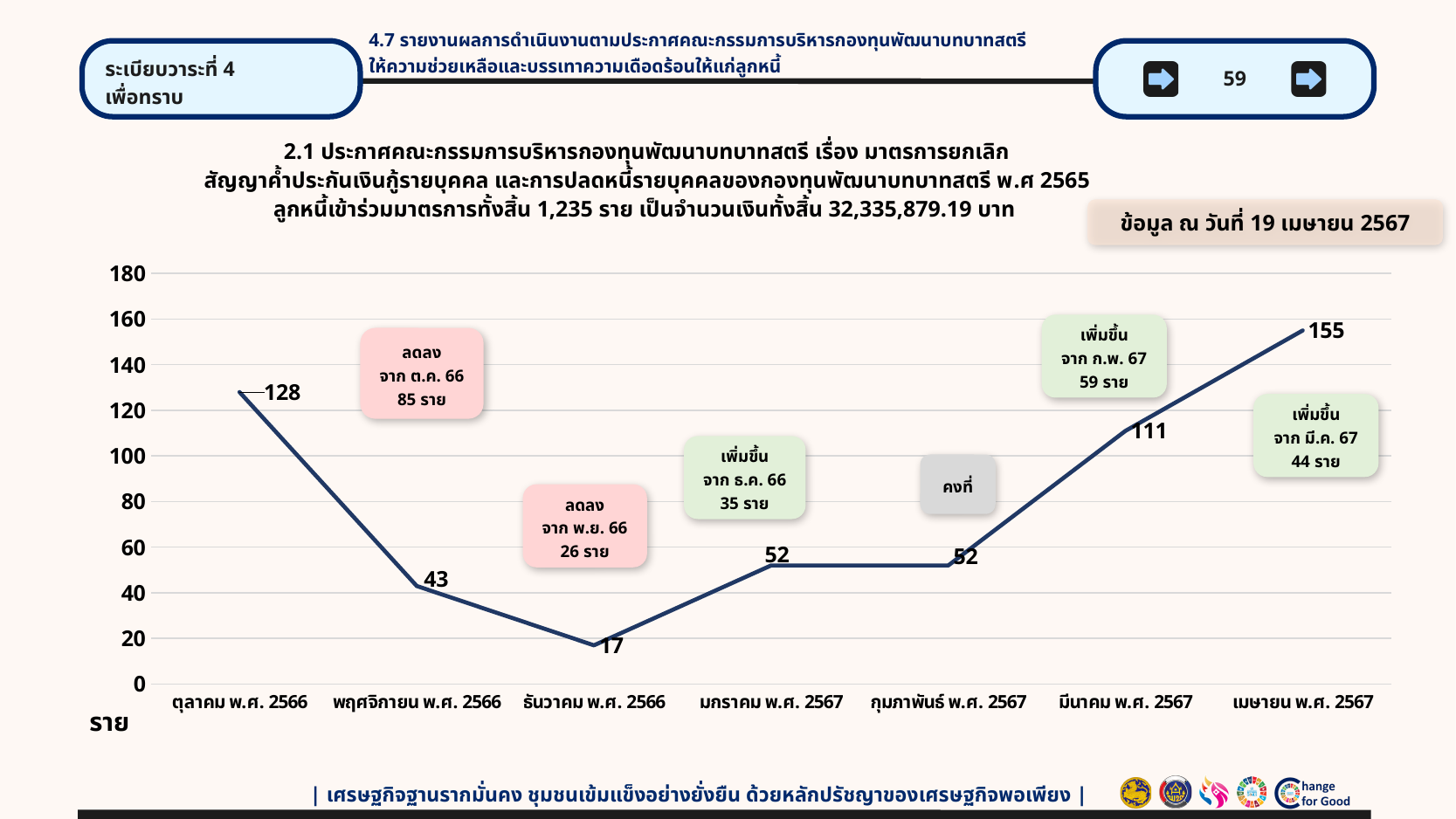
What is the value for ธันวาคม พ.ศ. 2566? 17 Which is larger, the value for ตุลาคม พ.ศ. 2566 or the value for มีนาคม พ.ศ. 2567? ตุลาคม พ.ศ. 2566 What type of chart is shown on the slide? line chart Do the values rise or fall from ธันวาคม พ.ศ. 2566 to เมษายน พ.ศ. 2567? rise What is the date shown in the box at the top right of the chart (ข้อมูล ณ วันที่)? 19 เมษายน 2567 What is the value for ตุลาคม พ.ศ. 2566? 128 Which month has the highest value? เมษายน พ.ศ. 2567 What is the difference between the values for เมษายน พ.ศ. 2567 and มีนาคม พ.ศ. 2567? 44 How many months are plotted on the x axis? 7 What is the difference between the values for ตุลาคม พ.ศ. 2566 and พฤศจิกายน พ.ศ. 2566? 85 What is the value for มีนาคม พ.ศ. 2567? 111 Which month has the lowest value? ธันวาคม พ.ศ. 2566